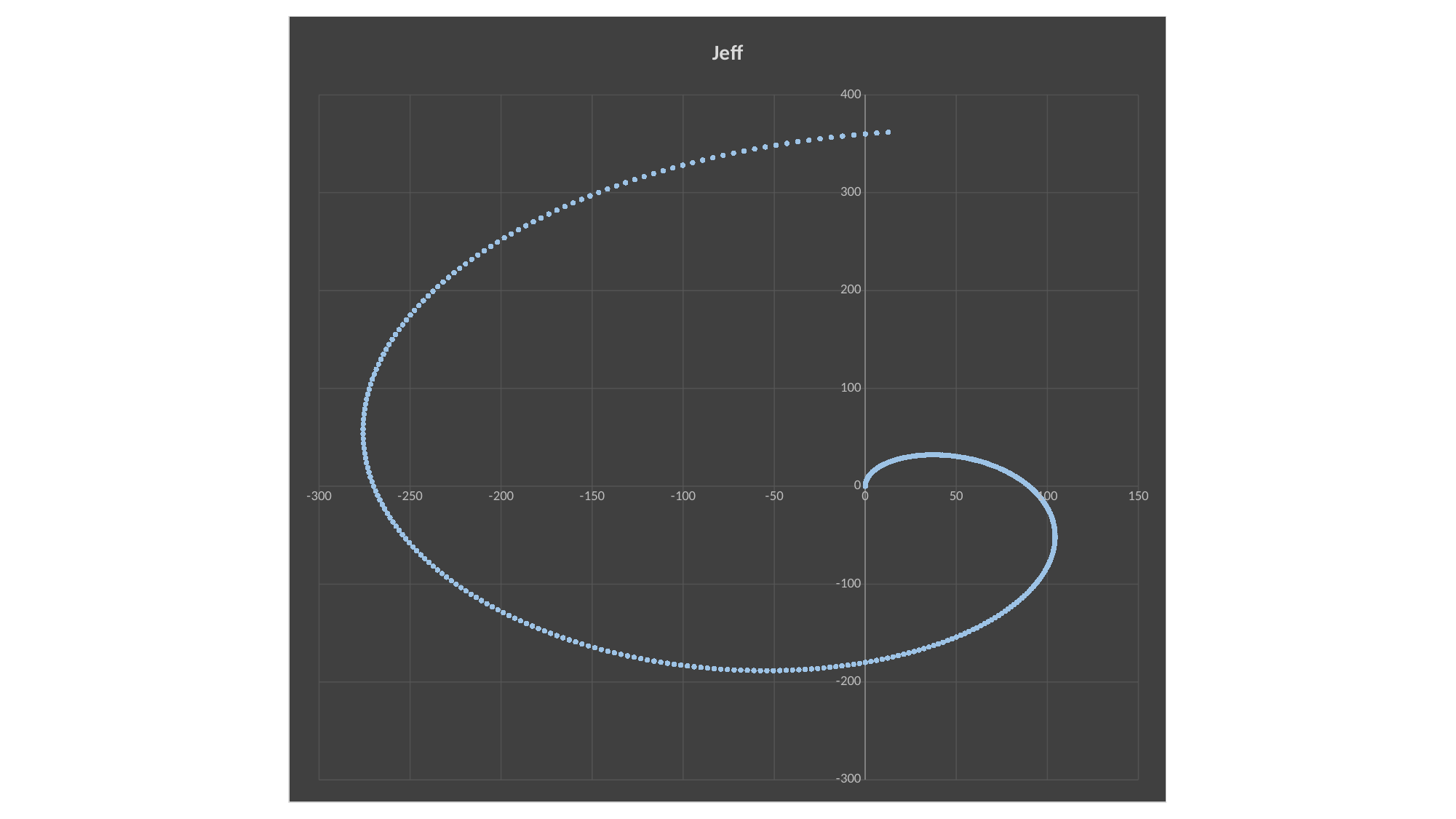
Is the lowest y value reached by the plotted points greater or less than -150? less Is the leftmost x value reached by the plotted points greater or less than -250? less Is the rightmost x value reached by the plotted points greater or less than 50? greater What is the title of the chart? Jeff What kind of chart is shown on the slide? scatter chart What is the highest value shown on the vertical axis of the chart? 400